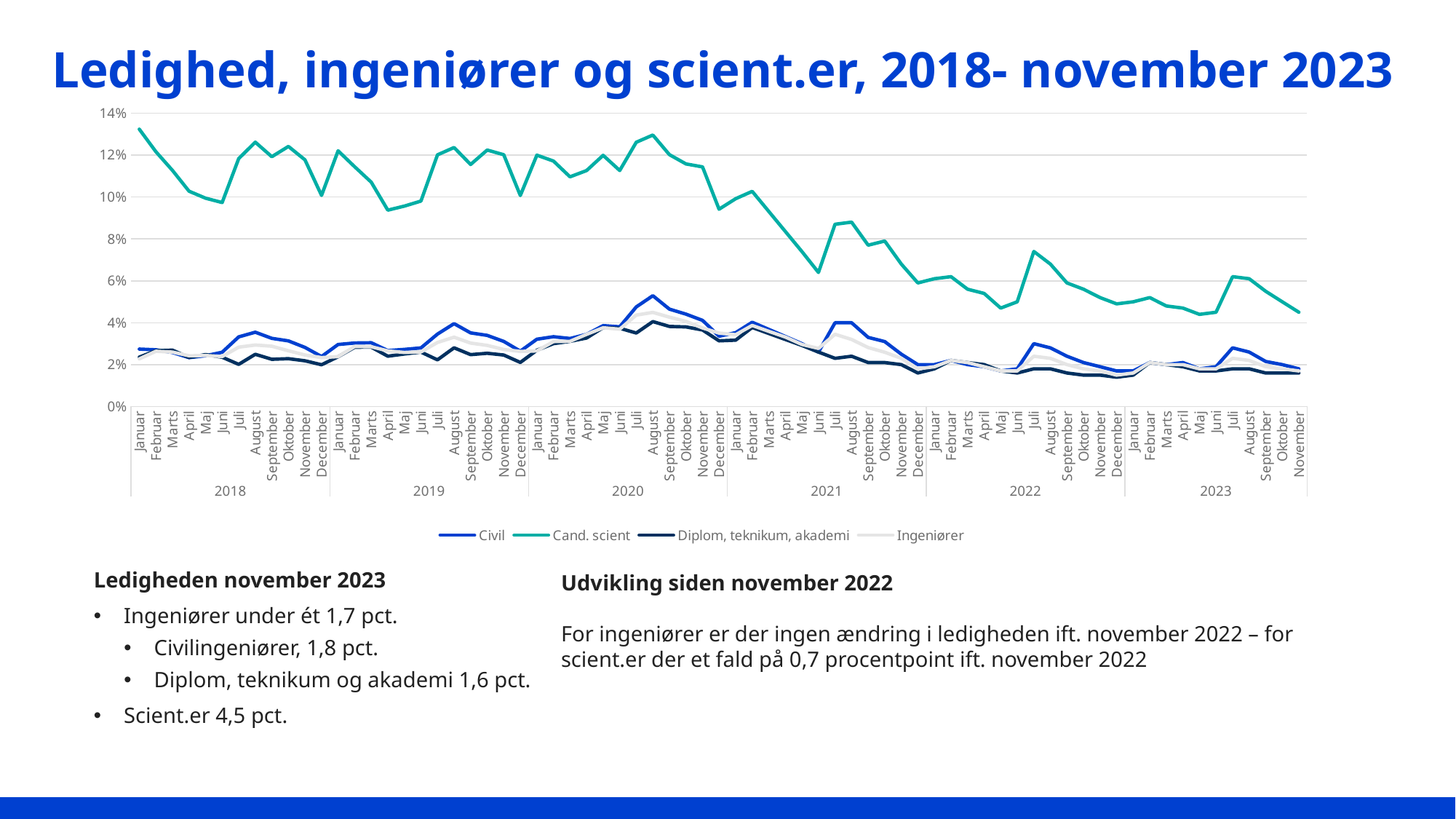
Does the Cand. scient line rise or fall overall from 2018 to November 2023? Fall Which series does the legend list in the teal colour? Cand. scient What is the difference between the November 2023 unemployment rates for Civilingeniører (1,8 pct.) and Diplom, teknikum og akademi (1,6 pct.)? 0,2 pct. How many years are labelled along the x axis? 6 Is the value for Cand. scient in November 2023 greater or less than 6%? less Is the value for Cand. scient in January 2018 greater or less than 12%? greater What kind of chart is shown on the slide? Line chart What is the unemployment rate for Civilingeniører in November 2023? 1,8 pct. In August 2020, which is larger: the value for Civil or the value for Cand. scient? Cand. scient What is the unemployment rate for Scient.er in November 2023? 4,5 pct. Which series has the highest unemployment rate across the whole period? Cand. scient How many series does the legend list? 4